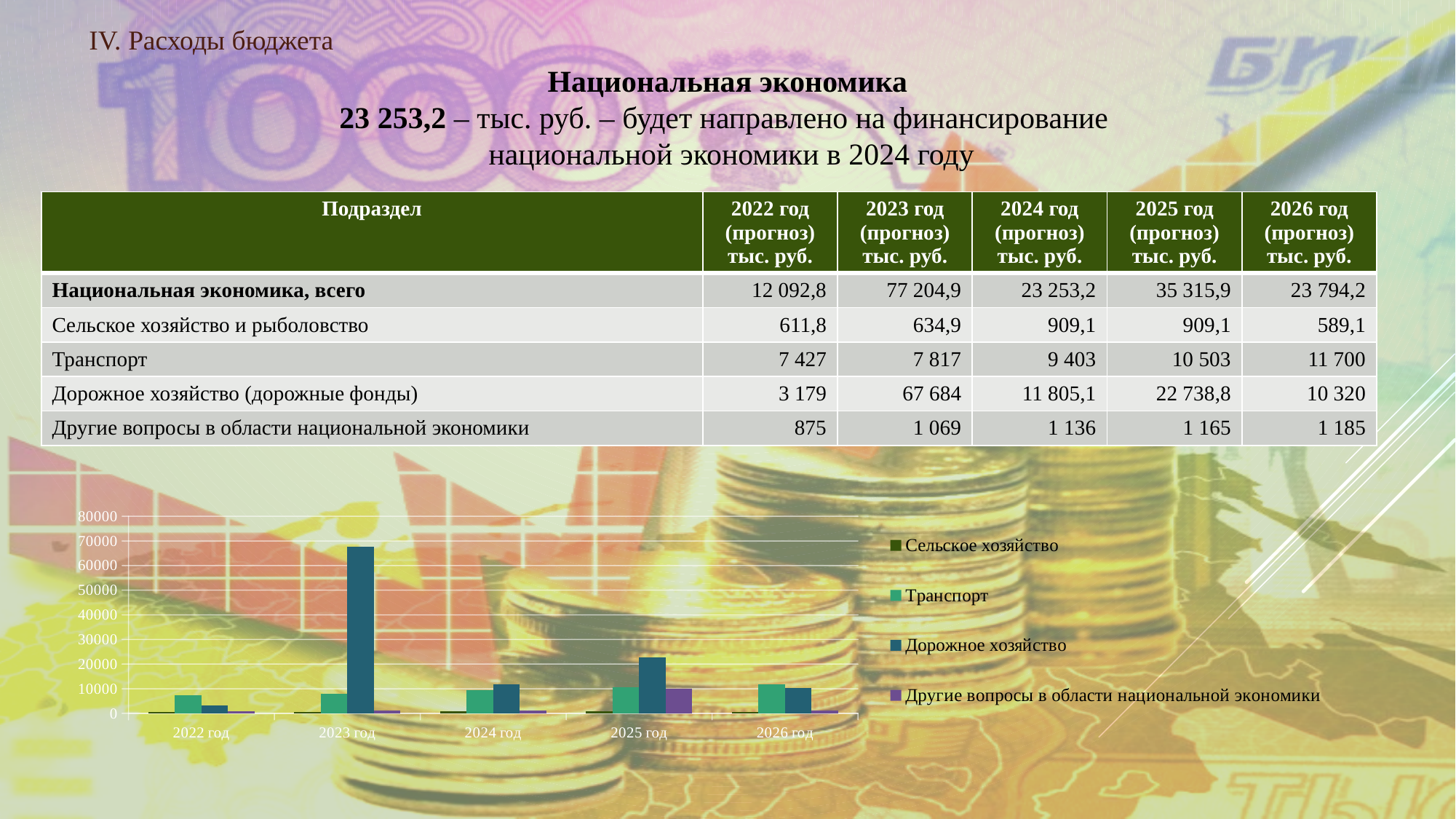
In the bar chart, is the value for Транспорт in 2026 год greater or less than 20000? less In the bar chart, which series has the smallest bars in every year? Сельское хозяйство In the bar chart, do the bars for Транспорт rise or fall from 2022 год to 2026 год? rise How many year categories are shown on the x axis of the bar chart? 5 In the bar chart, which is larger in 2026 год: Транспорт or Дорожное хозяйство? Транспорт According to the table on the slide, what is the value for Транспорт in 2024 год? 9 403 In the bar chart, which is larger in 2025 год: Транспорт or Дорожное хозяйство? Дорожное хозяйство How many series does the legend of the bar chart list? 4 In the bar chart, in which year is the bar for Дорожное хозяйство the tallest? 2023 год What is the highest value shown on the vertical axis of the bar chart? 80000 In the bar chart, is the value for Дорожное хозяйство in 2023 год greater or less than 60000? greater What kind of chart is shown at the bottom of the slide? bar chart